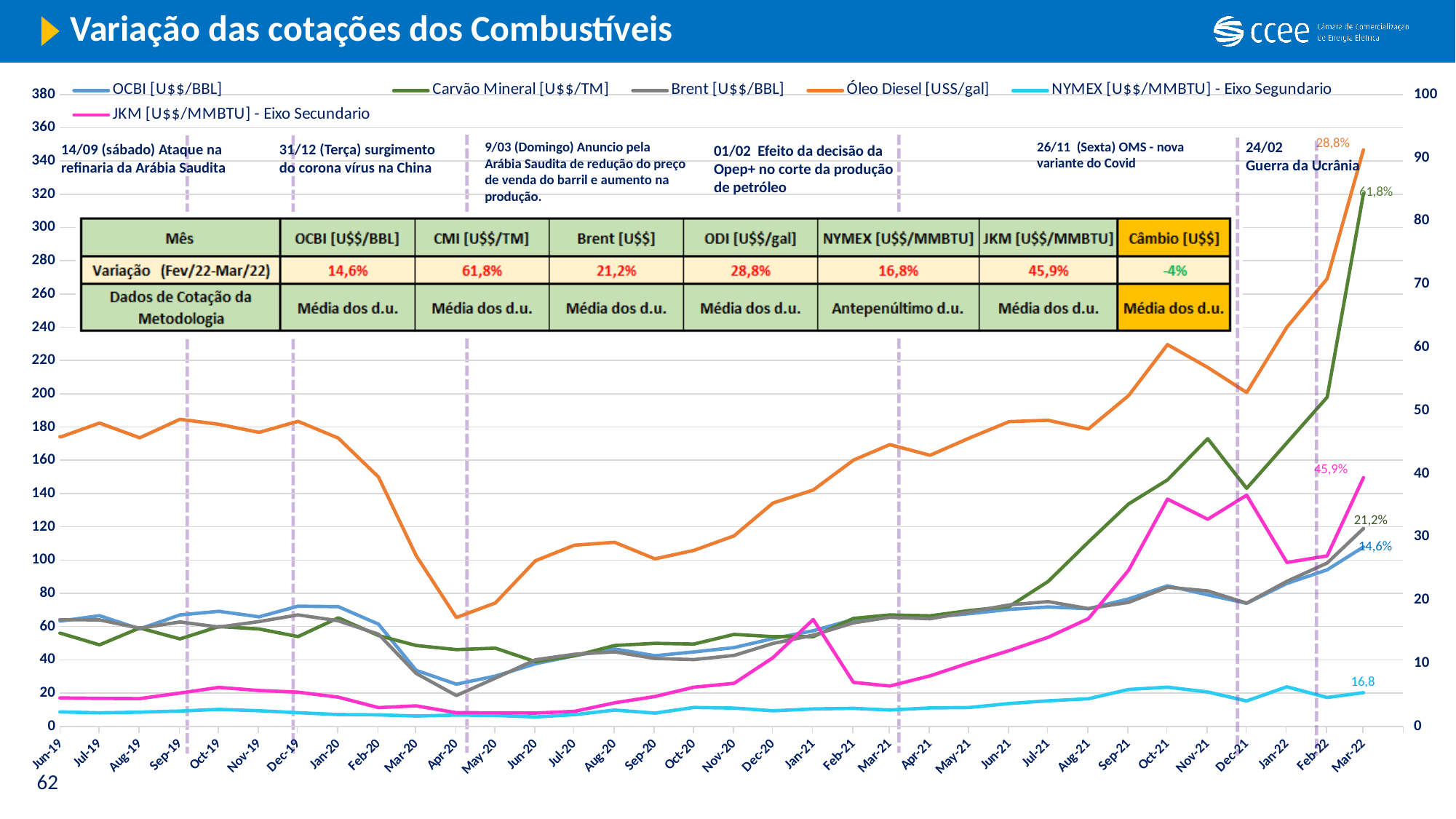
Is the value of Brent in Apr-20 greater or less than 40 on the left axis? less What is the difference between the variation labels of Carvão Mineral (61,8%) and OCBI (14,6%)? 47,2 percentage points Which series shows the highest variation percentage label at the end of its line? Carvão Mineral Is the value of Óleo Diesel in Mar-22 greater or less than 300 on the left axis? greater Which two series are plotted on the secondary axis according to the legend? NYMEX and JKM What kind of chart is shown on the slide? line chart How many series does the chart legend list? 6 How many monthly points are plotted along the x axis, from Jun-19 to Mar-22? 34 What variation percentage is labelled at the end of the Óleo Diesel line? 28,8% Which series shows the lowest variation percentage label at the end of its line? OCBI What variation percentage is labelled at the end of the Carvão Mineral line? 61,8% Does the Óleo Diesel line rise or fall from Dec-21 to Mar-22? rises